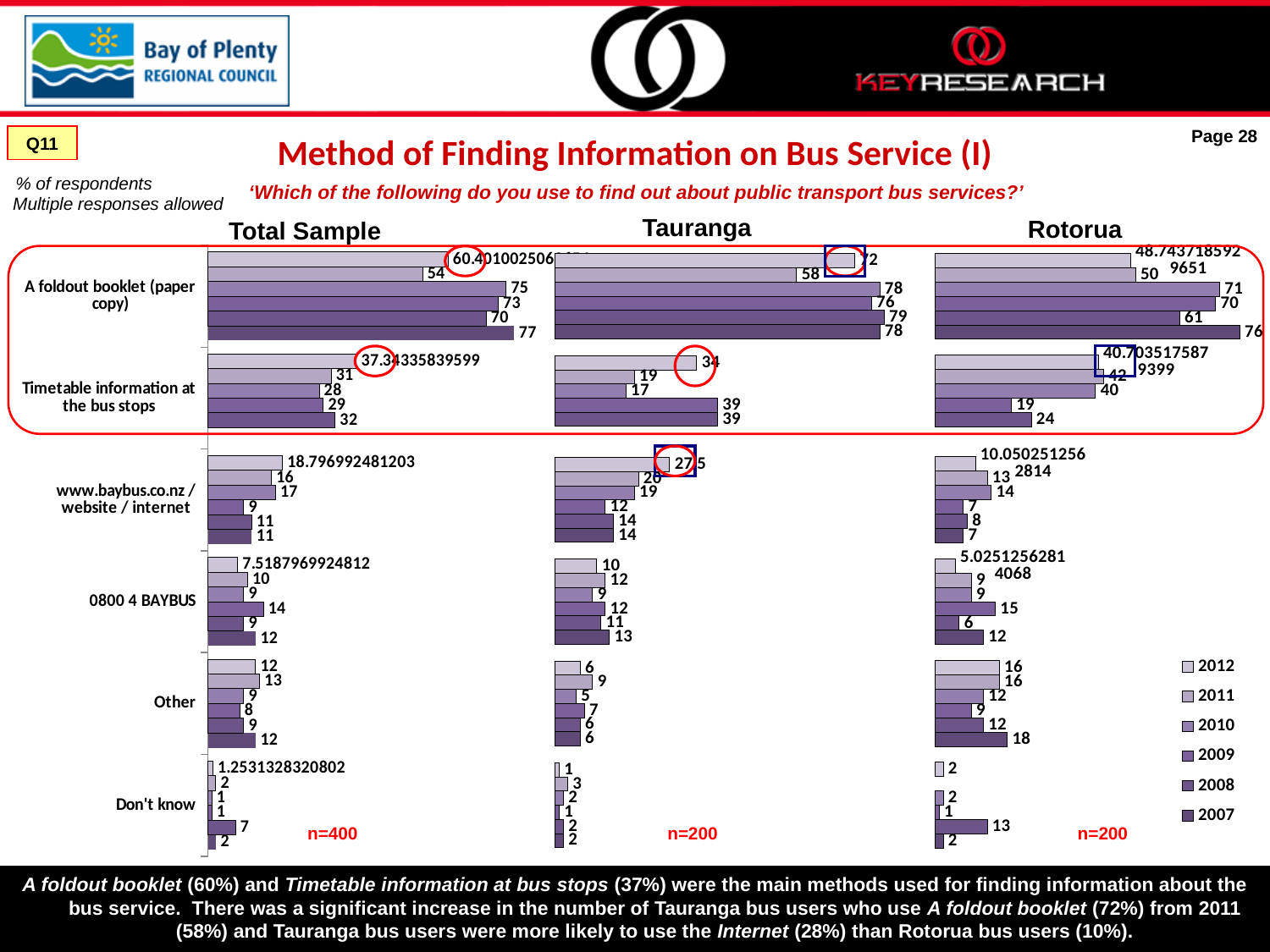
In the Rotorua chart, which year has the highest value for 'A foldout booklet (paper copy)'? 2007 In the Total Sample chart, what is the 2011 value for 'A foldout booklet (paper copy)'? 54 What sample size (n) is shown for the Total Sample chart? n=400 In the Tauranga chart, what is the 2012 value for 'A foldout booklet (paper copy)'? 72 In the Total Sample chart, what is the 2007 value for 'A foldout booklet (paper copy)'? 77 What kind of chart is used for the Total Sample, Tauranga and Rotorua panels? bar chart In the Tauranga chart, what is the 2011 value for 'A foldout booklet (paper copy)'? 58 In the Rotorua chart, which is larger for 'Other': the 2007 value or the 2009 value? 2007 In the Tauranga chart, what is the difference between the 2012 and 2011 values for 'A foldout booklet (paper copy)'? 14 How many categories (methods) are shown on the Total Sample chart? 6 How many series does the legend list? 6 In the Rotorua chart, what is the 2007 value for 'Other'? 18